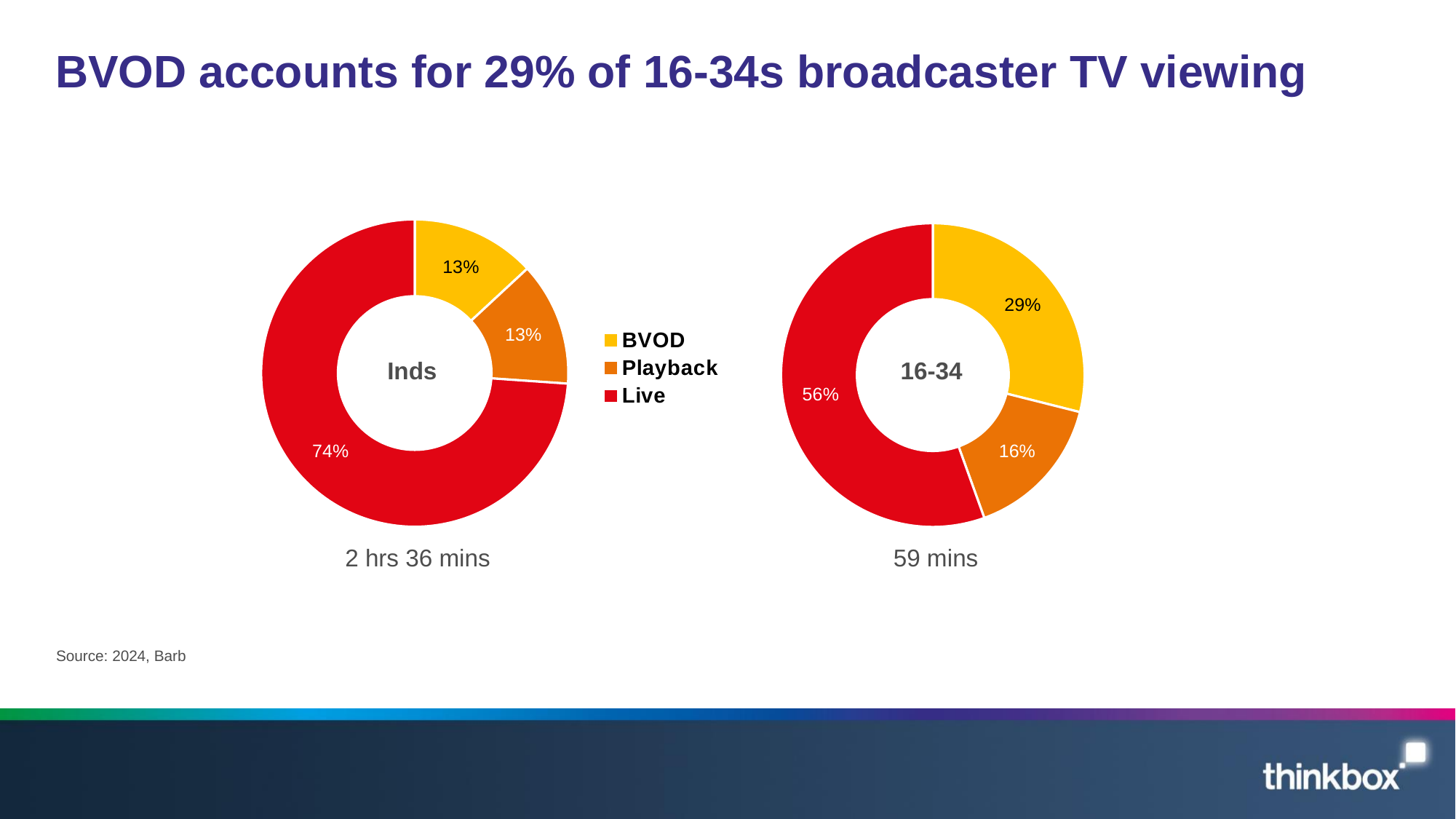
In the 16-34 donut chart, which category has the smallest share? Playback What total viewing time is shown beneath the Inds donut chart? 2 hrs 36 mins In the Inds donut chart, what share of viewing is Live? 74% Which colour represents Playback in the legend? Orange In the Inds donut chart, what share of viewing is BVOD? 13% How many series does the legend list? 3 What is the difference between the Live share in the Inds chart and the Live share in the 16-34 chart? 18 percentage points In the 16-34 donut chart, what share of viewing is BVOD? 29% In the 16-34 donut chart, which category has the largest share? Live What kind of chart is used on this slide? Donut (pie) chart Is the BVOD share larger in the Inds chart or the 16-34 chart? 16-34 In the 16-34 donut chart, what share of viewing is Playback? 16%